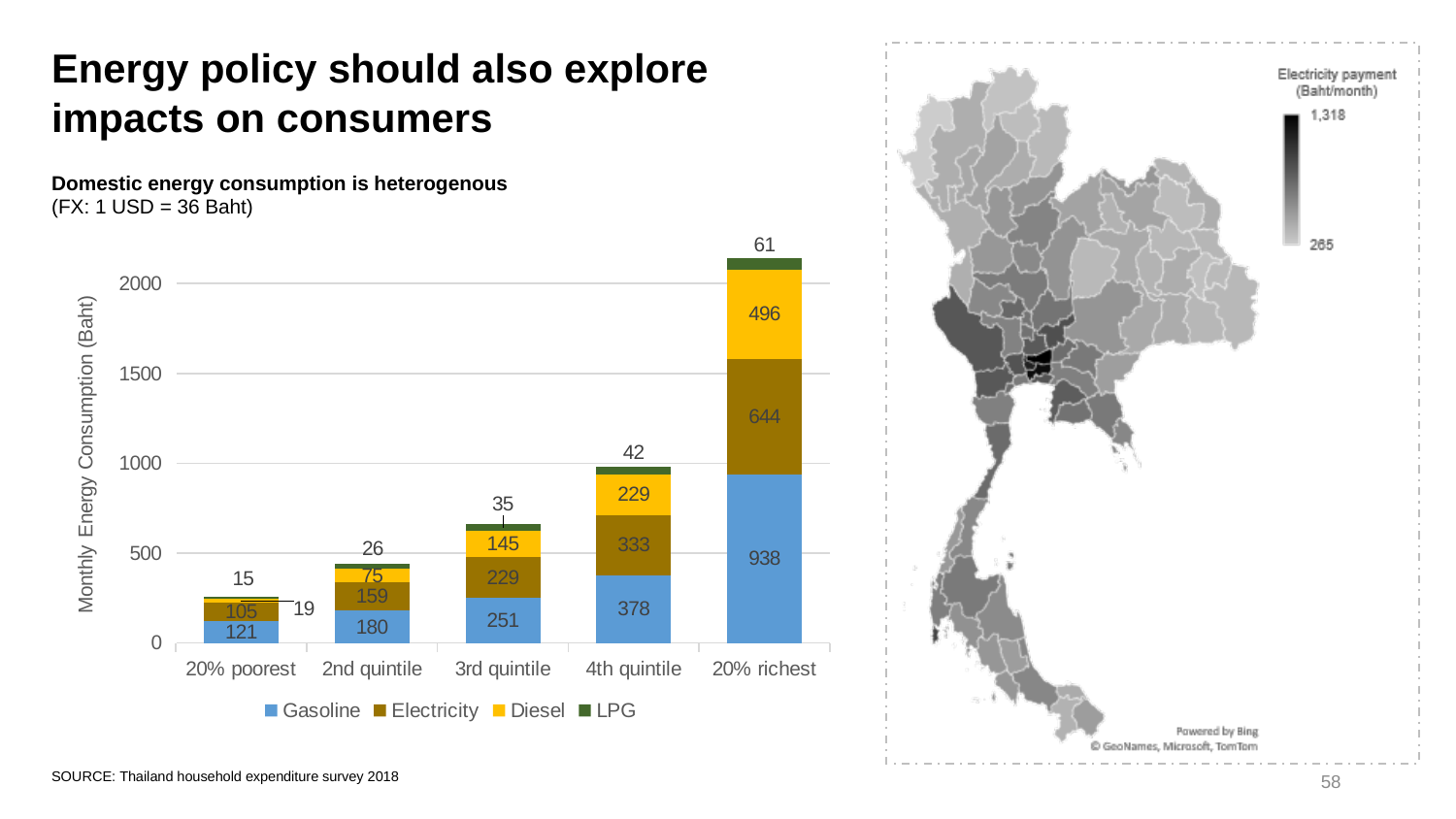
In the stacked bar chart, how many series does the legend list? 4 In the stacked bar chart, which category has the highest Gasoline value? 20% richest In the stacked bar chart, what is the total monthly energy consumption for the 20% richest? 2139 In the stacked bar chart, what is the LPG value for the 2nd quintile? 26 In the stacked bar chart, what is the Diesel value for the 3rd quintile? 145 In the stacked bar chart, what is the Electricity value for the 4th quintile? 333 In the stacked bar chart, what is the Gasoline value for the 20% richest? 938 In the stacked bar chart, what is the difference between the Electricity values for the 20% richest and the 4th quintile? 311 In the stacked bar chart, which is larger: the Gasoline value for the 3rd quintile or the Electricity value for the 4th quintile? Electricity value for the 4th quintile In the map on the right, what is the maximum electricity payment shown on the colour scale? 1,318 In the stacked bar chart, which category has the lowest Diesel value? 20% poorest What kind of chart is the chart on the left of the slide? Stacked bar chart